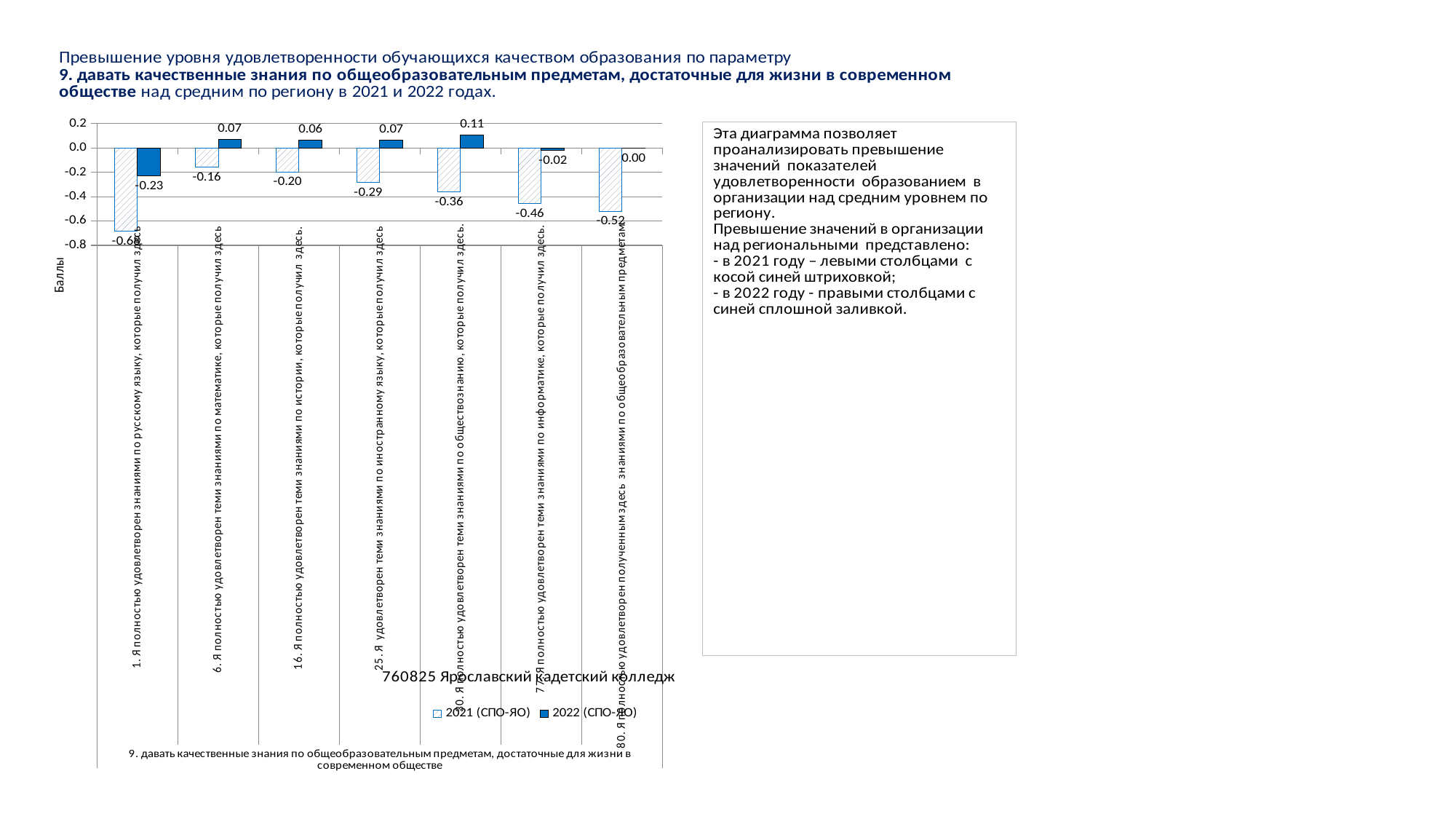
What is the 2022 (СПО-ЯО) value for the category about knowledge in mathematics (по математике)? 0.07 What is the 2021 (СПО-ЯО) value for the category about knowledge in informatics (по информатике)? -0.46 What is the 2022 (СПО-ЯО) value for the category about knowledge in social studies (по обществознанию)? 0.11 How many categories are shown on the x axis of the chart? 7 Which category has the lowest 2021 (СПО-ЯО) value? 1. Я полностью удовлетворен знаниями по русскому языку, которые получил здесь What is the difference between the 2022 and 2021 values for the category about knowledge in history (по истории)? 0.26 Which category has the highest 2022 (СПО-ЯО) value? 30. Я полностью удовлетворен теми знаниями по обществознанию, которые получил здесь. How many series does the chart legend list? 2 Is the 2021 (СПО-ЯО) value for the Russian language category (по русскому языку) greater or less than -0.6? less What is the 2022 (СПО-ЯО) value for the last category, about knowledge in general education subjects (по общеобразовательным предметам)? 0.00 For 2021 (СПО-ЯО), which is larger: the value for foreign language (по иностранному языку) or for social studies (по обществознанию)? по иностранному языку What type of chart is shown on the slide? bar chart